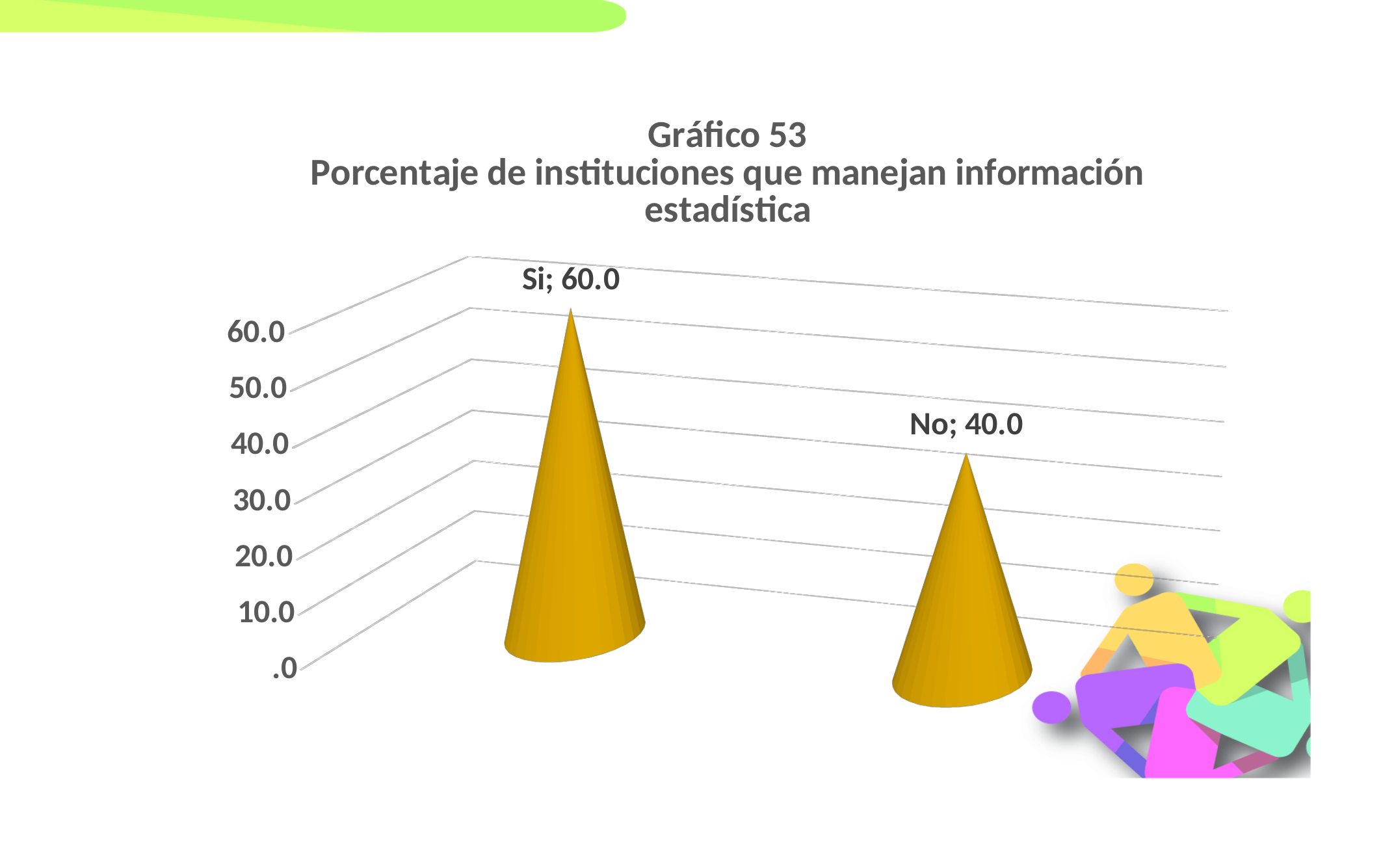
What is the value for No? 40.0 What is the difference between the values for Si and No? 20.0 Is the value for No greater or less than 50.0? less Which category has the highest value? Si Which is larger, the value for Si or the value for No? Si What is the total of the values for Si and No? 100.0 What is the value for Si? 60.0 What kind of chart is shown on the slide? bar chart How many categories are plotted in the chart? 2 Which category has the lowest value? No What is the title of the chart? Gráfico 53 Porcentaje de instituciones que manejan información estadística What is the highest value shown on the vertical axis? 60.0